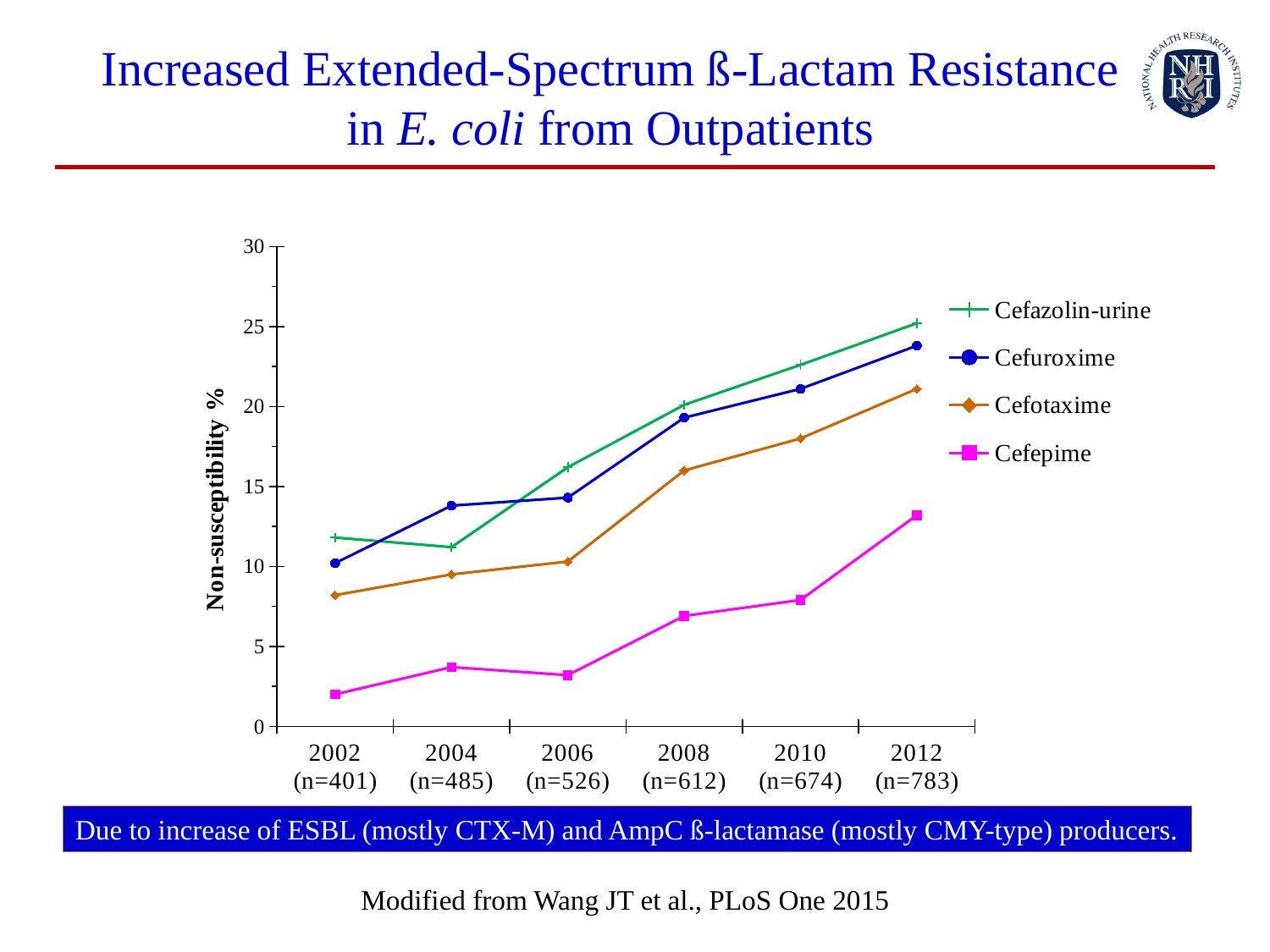
What is the label on the y axis? Non-susceptibility % Is the value for Cefepime in 2002 greater or less than 5? less How many time points are plotted along the x axis? 6 How many series does the legend list? 4 What kind of chart is shown on the slide? line chart Which series has the lowest non-susceptibility across all years? Cefepime Which series has the highest non-susceptibility in 2012? Cefazolin-urine Does the non-susceptibility for Cefotaxime rise or fall from 2002 to 2012? rise Is the value for Cefuroxime in 2012 greater or less than 25? less In 2010, which is larger: Cefuroxime or Cefotaxime? Cefuroxime Is the value for Cefotaxime in 2002 greater or less than 10? less